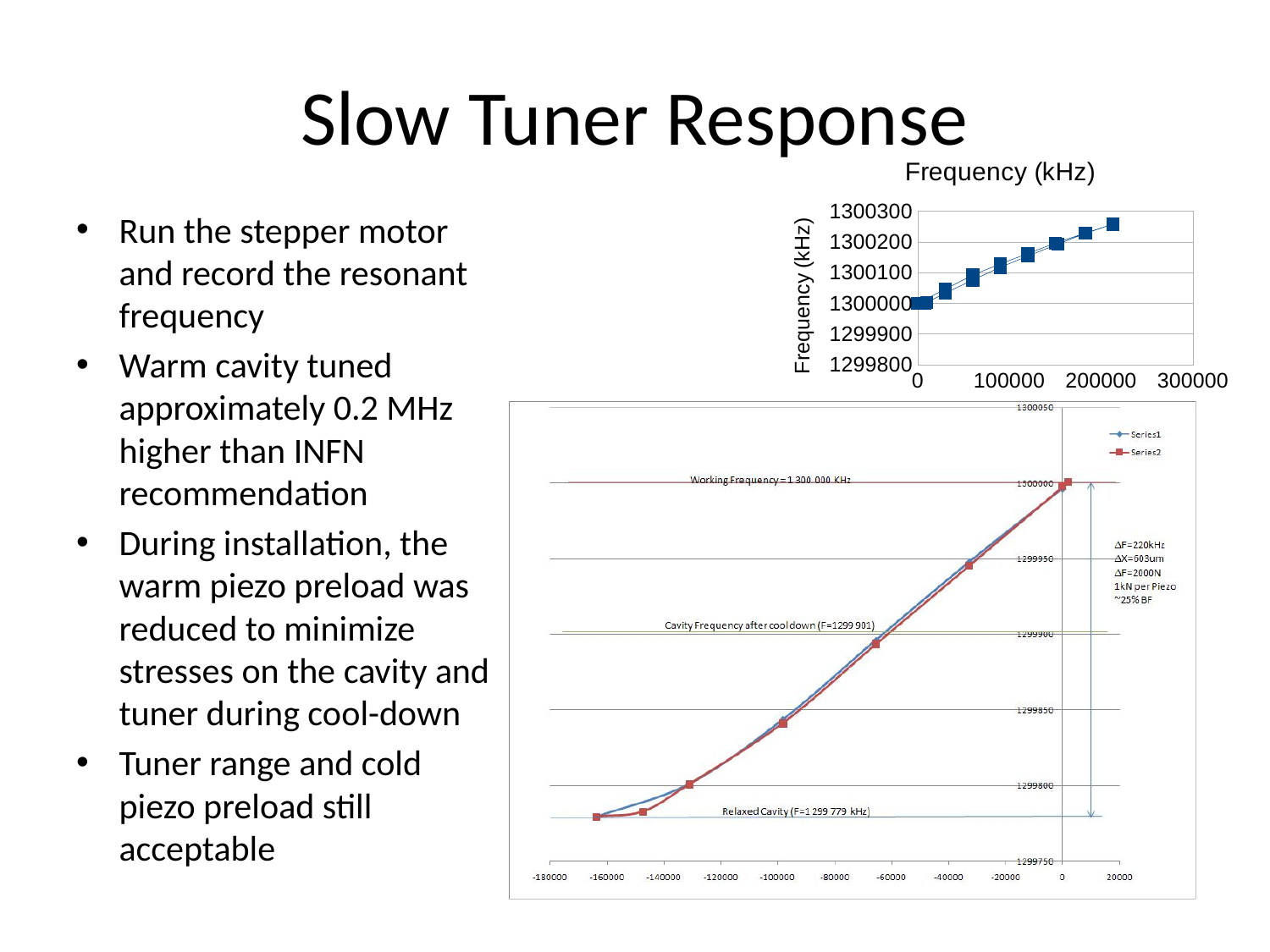
In the top-right chart titled "Frequency (kHz)", what is the highest tick value shown on the x axis? 300000 In the top-right chart titled "Frequency (kHz)", is the value of the rightmost plotted point greater or less than 1300200? greater In the bottom chart, what frequency is annotated for the relaxed cavity? 1 299 779 kHz In the bottom chart, do the plotted values rise or fall as the x-axis value increases from -180000 toward 0? rise In the top-right chart titled "Frequency (kHz)", is the value of the leftmost plotted point (at x = 0) greater or less than 1300100? less In the top-right chart titled "Frequency (kHz)", do the plotted values rise or fall as the x-axis value increases? rise In the bottom chart, what are the names of the series listed in the legend? Series1 and Series2 In the bottom chart, which is larger: the annotated working frequency or the annotated relaxed cavity frequency? working frequency In the top-right chart titled "Frequency (kHz)", what is the label on the vertical axis? Frequency (kHz) In the bottom chart, what working frequency is annotated on the horizontal reference line? 1 300 000 KHz In the bottom chart, how many series does the legend list? 2 In the bottom chart, what cavity frequency after cool down is annotated? 1299 901